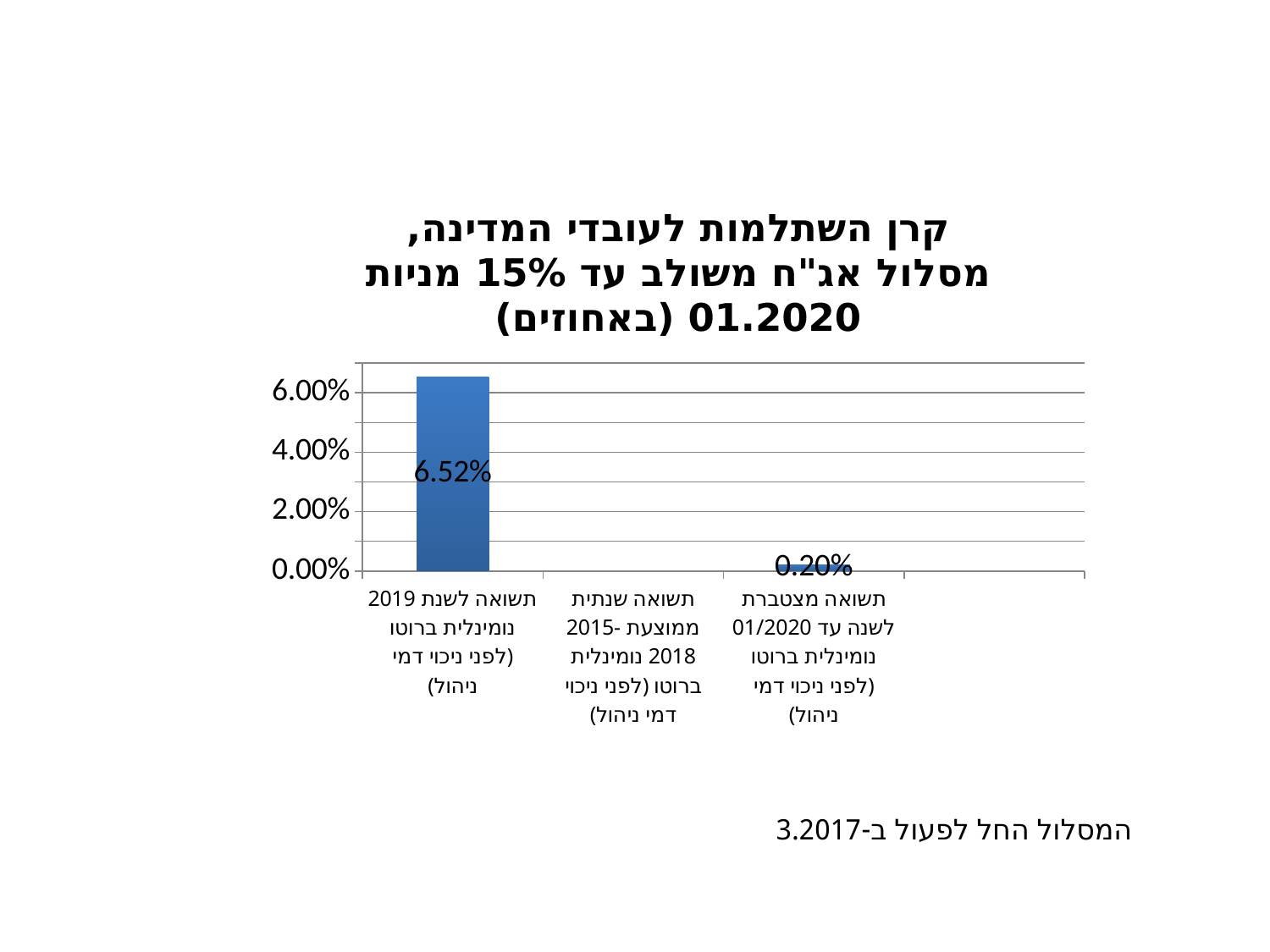
Which is larger: the value for "תשואה לשנת 2019" or the value for "תשואה מצטברת לשנה עד 01/2020"? תשואה לשנת 2019 What is the difference between the value for "תשואה לשנת 2019" and the value for "תשואה מצטברת לשנה עד 01/2020"? 6.32% Is the value for "תשואה מצטברת לשנה עד 01/2020" greater or less than 2.00%? less What is the highest value printed on the y axis of the chart? 6.00% Is the value for "תשואה לשנת 2019" greater or less than 6.00%? greater What kind of chart is shown on the slide? bar chart What is the title of the chart? קרן השתלמות לעובדי המדינה, מסלול אג"ח משולב עד 15% מניות 01.2020 (באחוזים) Which category has the highest value in the chart? תשואה לשנת 2019 נומינלית ברוטו (לפני ניכוי דמי ניהול) What is the value for the category "תשואה מצטברת לשנה עד 01/2020 נומינלית ברוטו (לפני ניכוי דמי ניהול)"? 0.20% How many categories are shown on the x axis of the chart? 3 What is the value for the category "תשואה לשנת 2019 נומינלית ברוטו (לפני ניכוי דמי ניהול)"? 6.52%